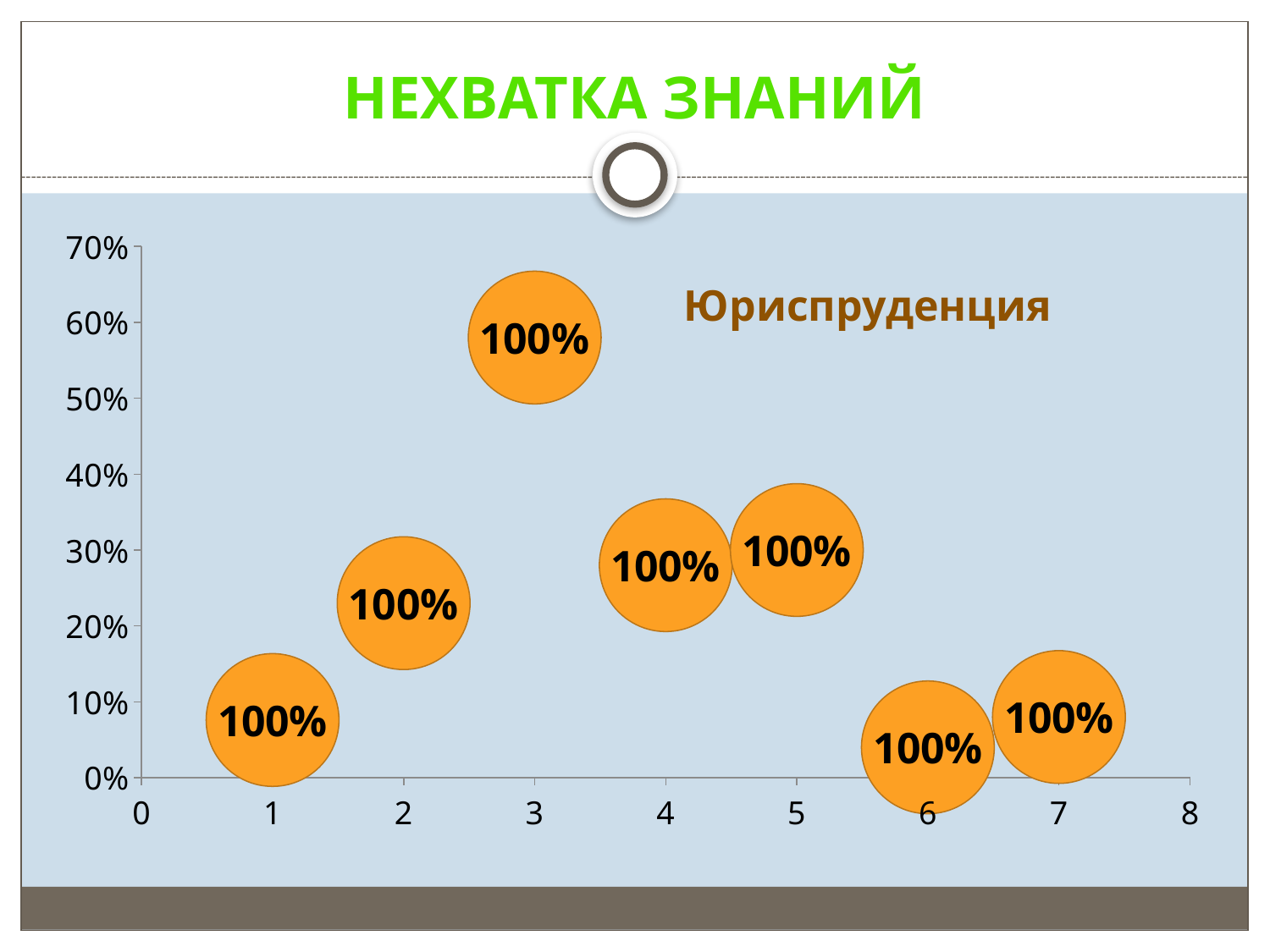
What is the title of the slide containing the chart? НЕХВАТКА ЗНАНИЙ Which bubble is positioned higher on the vertical axis, the one at x = 2 or the one at x = 7? x = 2 What kind of chart is shown on the slide? bubble chart How many bubbles are plotted on the chart? 7 What series name is written inside the chart area? Юриспруденция Is the vertical position of the bubble at x = 5 greater or less than 20%? greater Is the vertical position of the bubble at x = 1 greater or less than 20%? less What data label is shown on the bubble at x = 6? 100% Is the vertical position of the bubble at x = 3 greater or less than 50%? greater At which x value is the bubble positioned highest on the vertical axis? 3 At which x value is the bubble positioned lowest on the vertical axis? 6 What is the data label shown on the bubble at x = 3? 100%